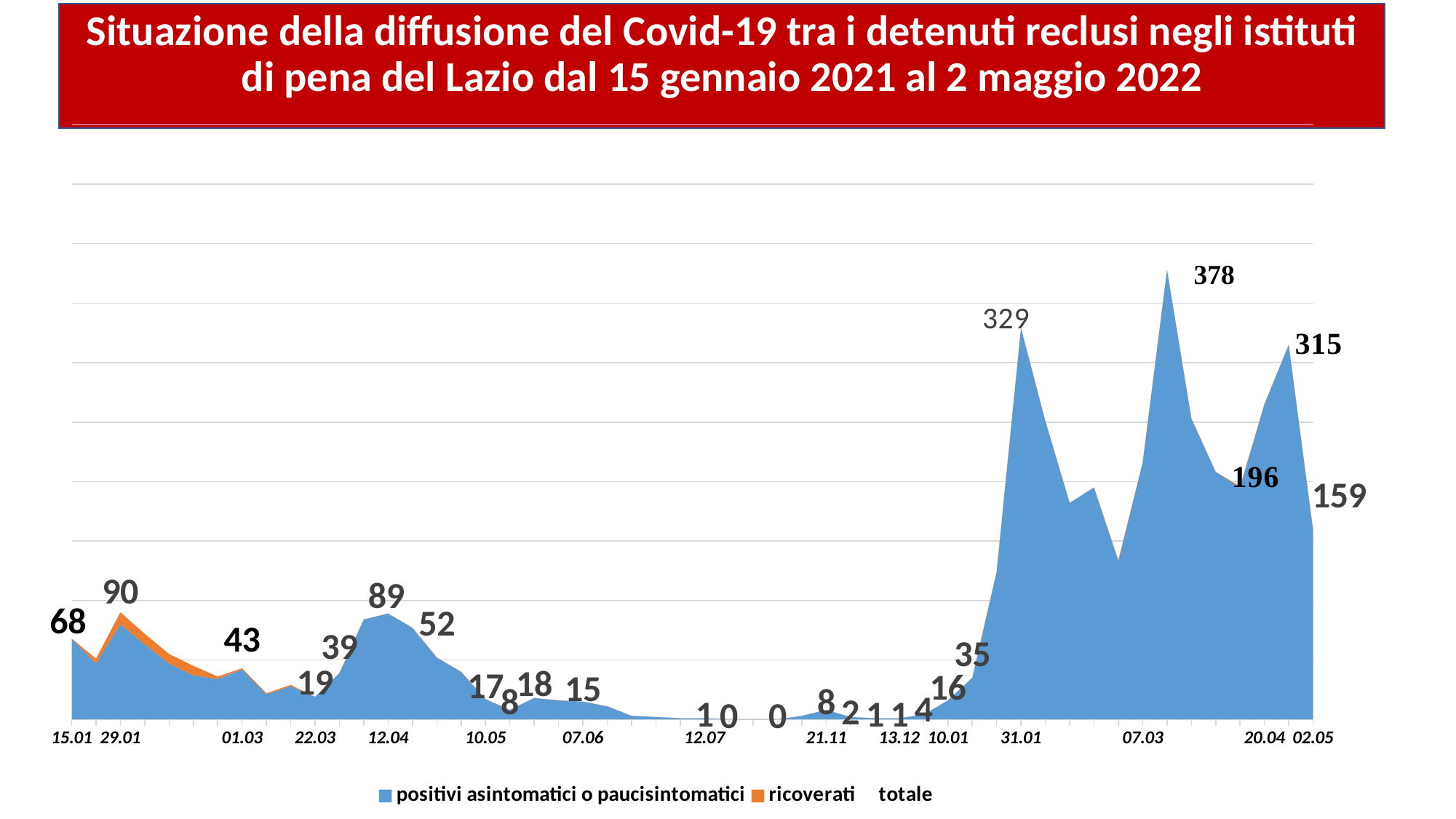
What type of chart is shown on the slide? area chart What is the highest value labelled on the chart? 378 Which is larger, the value labelled at 29.01 or the value labelled at 12.04? 29.01 What is the difference between the peak value 378 and the value labelled at 31.01 (329)? 49 What is the lowest value labelled on the chart? 0 Which series is shown in orange in the legend? ricoverati What is the value labelled at 12.04? 89 What is the value labelled at 02.05? 159 What is the value labelled at 15.01? 68 What is the value labelled at 29.01? 90 What is the value labelled at 31.01? 329 How many series does the legend list? 3